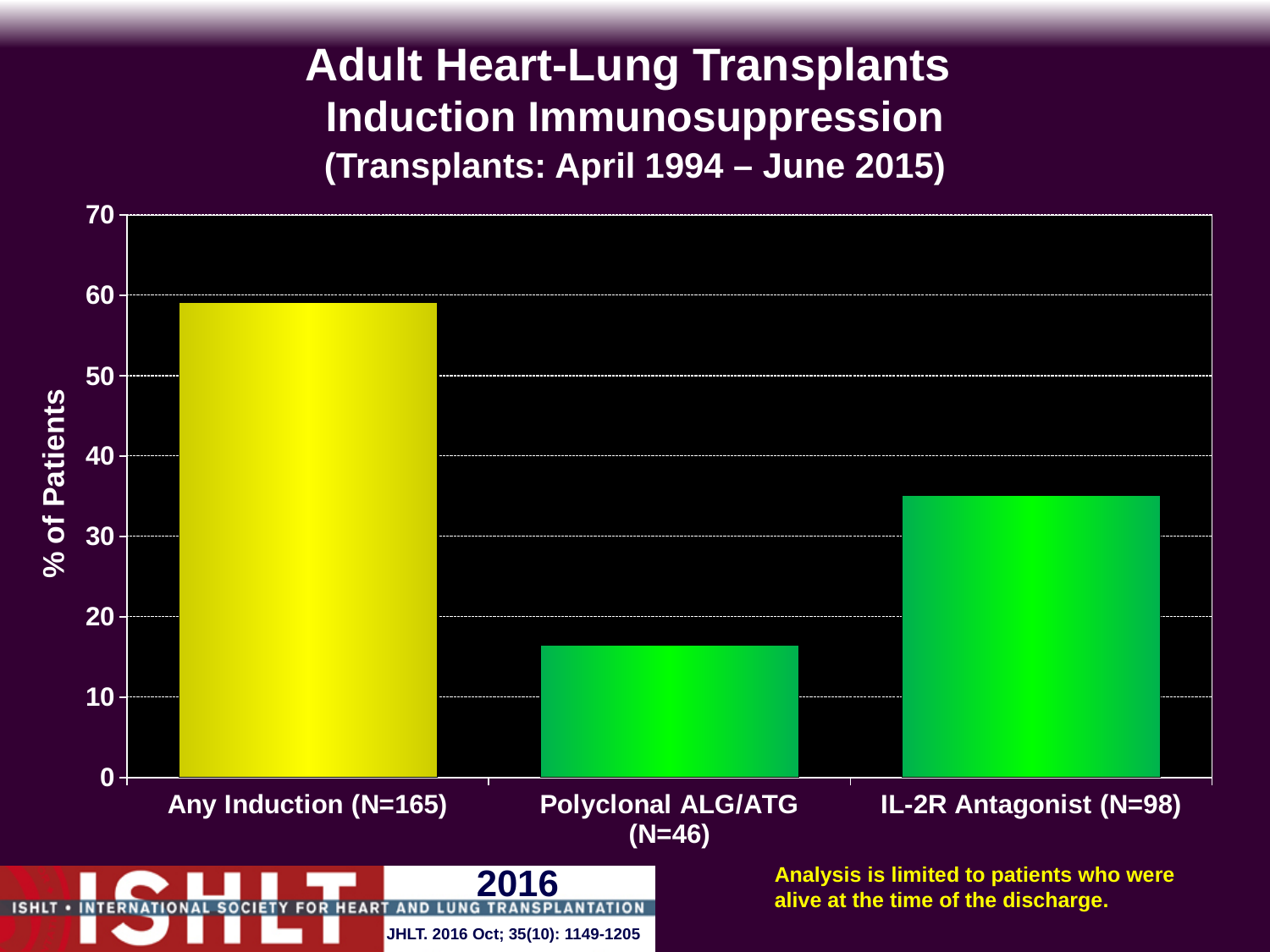
What is the label of the y axis? % of Patients How many categories are plotted on the x axis? 3 Which is larger, the value for IL-2R Antagonist (N=98) or the value for Polyclonal ALG/ATG (N=46)? IL-2R Antagonist (N=98) What kind of chart is shown on the slide? bar chart Is the value for Polyclonal ALG/ATG (N=46) greater or less than 20? less Which category has the highest % of patients? Any Induction (N=165) What is the maximum value shown on the y axis? 70 Which category has the lowest % of patients? Polyclonal ALG/ATG (N=46) Is the value for Polyclonal ALG/ATG (N=46) greater or less than 10? greater Is the value for IL-2R Antagonist (N=98) greater or less than 30? greater